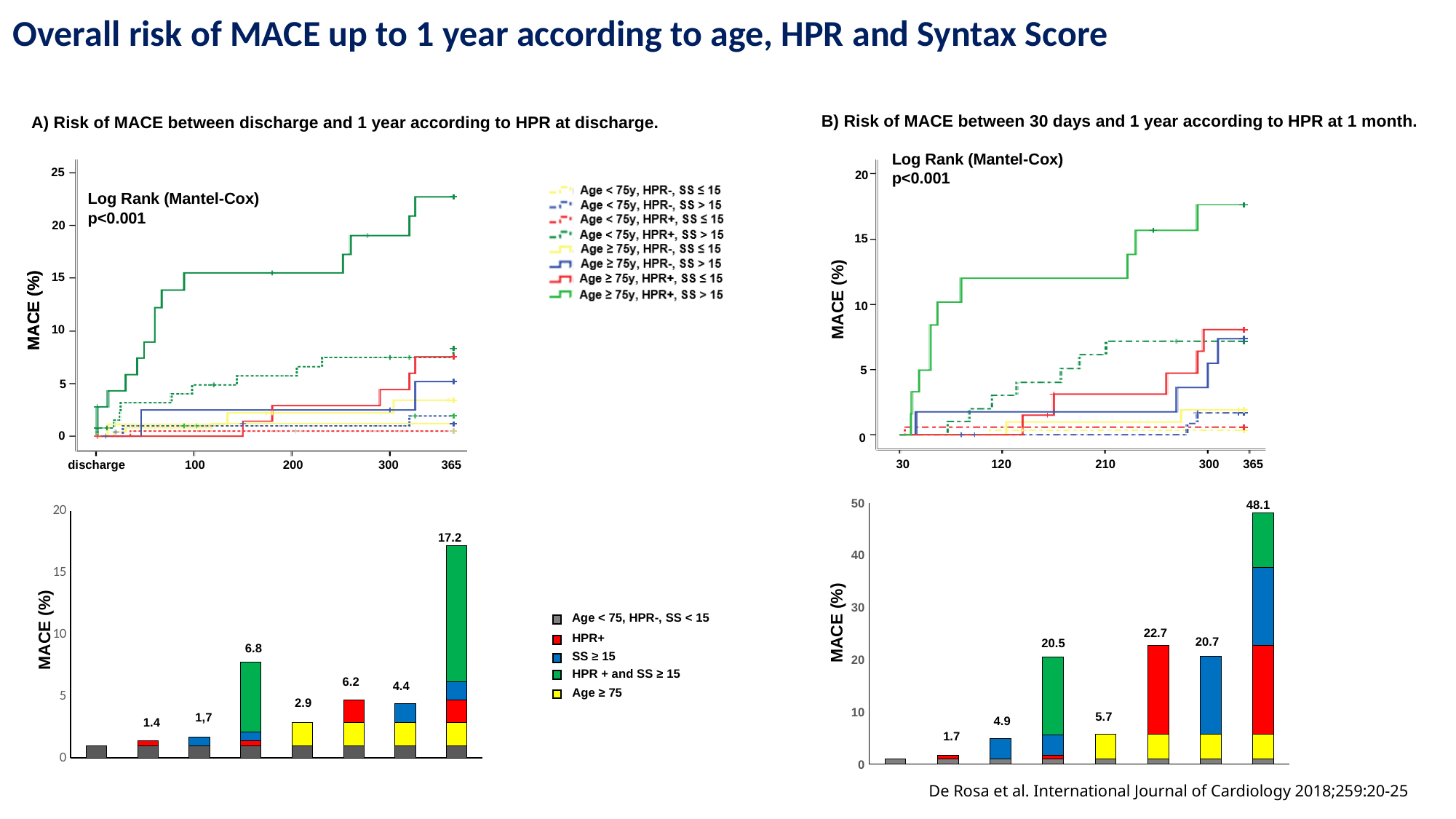
What kind of chart is the bottom-right chart in panel B? Stacked bar chart How many entries does the legend of the bottom-left stacked bar chart (panel A) list? 5 How many bars are shown in the bottom-left stacked bar chart (panel A)? 8 In the bottom-left stacked bar chart (panel A), what is the total of the tallest bar? 17.2 In the bottom-right stacked bar chart (panel B), what is the difference between the tallest bar (48.1) and the bar labelled 22.7? 25.4 In the top-left line chart (panel A), is the value of the Age ≥ 75y, HPR+, SS > 15 series at 365 days greater or less than 20? greater In the bottom-right stacked bar chart (panel B), what is the total of the tallest bar? 48.1 What Log Rank (Mantel-Cox) p-value is shown on the top-left line chart (panel A)? p<0.001 In the top-left line chart (panel A), which series reaches the highest MACE (%) at 365 days? Age ≥ 75y, HPR+, SS > 15 In the bottom-left stacked bar chart (panel A), what is the difference between the bars labelled 6.8 and 6.2? 0.6 How many series does the legend of the top-left line chart (panel A) list? 8 In the bottom-right stacked bar chart (panel B), which is larger: the sixth bar (22.7) or the seventh bar (20.7)? the sixth bar (22.7)